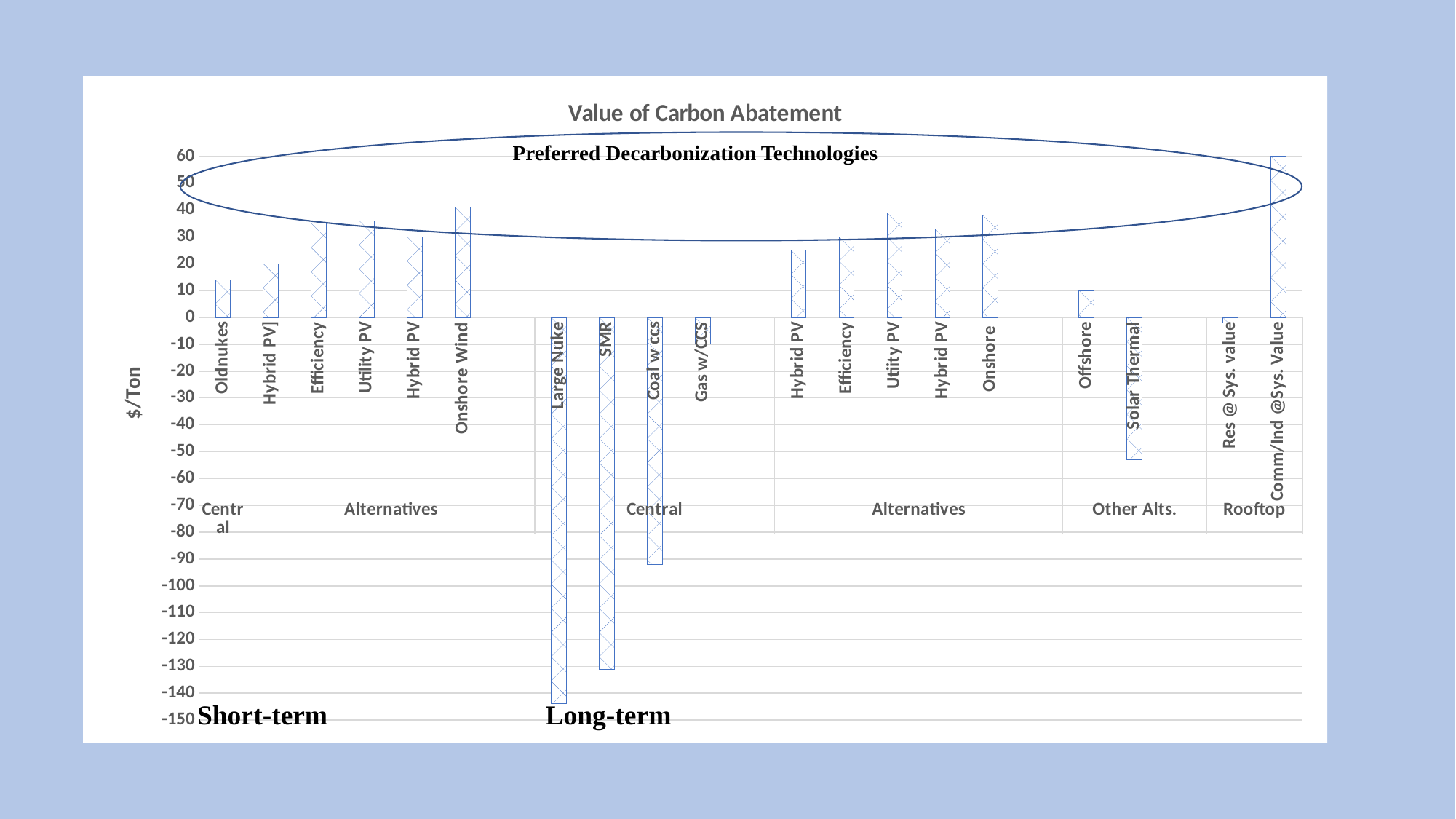
Is the value for Solar Thermal greater or less than -40? less Is the value for Large Nuke greater or less than -100? less Is the value for Coal w ccs greater or less than -100? greater Which category has the highest value in the chart? Comm/Ind @Sys. Value Which category has the lowest value in the chart? Large Nuke What kind of chart is shown on the slide? bar chart Which has the larger value, Oldnukes or Onshore Wind? Onshore Wind What is the title of the chart? Value of Carbon Abatement How many bars are plotted in the chart? 19 What is the label on the vertical axis of the chart? $/Ton